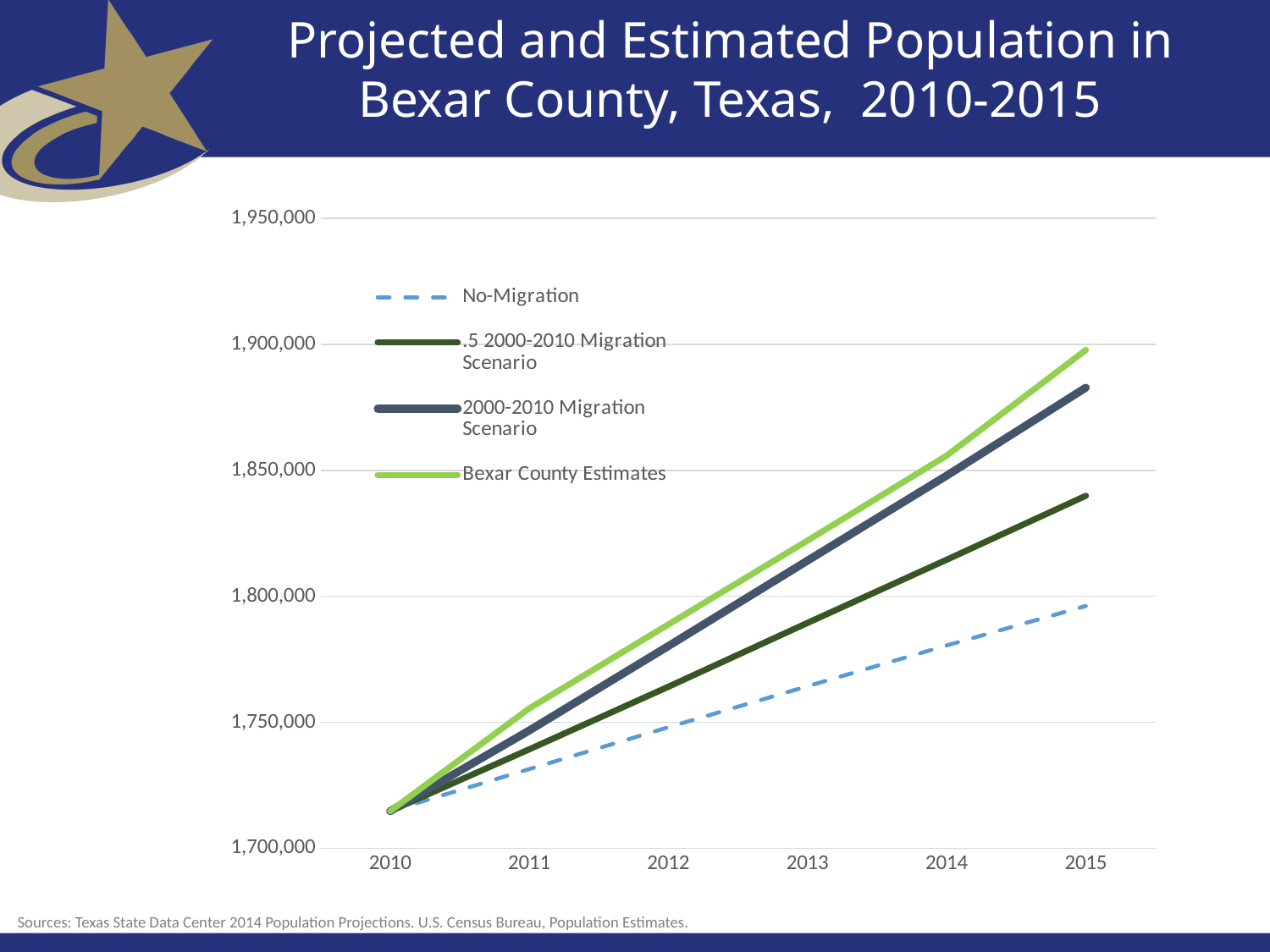
How many series does the legend list? 4 How many years are shown along the x axis? 6 Is the value for No-Migration in 2015 greater or less than 1,750,000? greater What kind of chart is shown on the slide? Line chart Is the value for the .5 2000-2010 Migration Scenario in 2015 greater or less than 1,850,000? less Which series is drawn with a dashed line? No-Migration Which series has the highest value in 2015? Bexar County Estimates Is the value for Bexar County Estimates in 2015 greater or less than 1,850,000? greater In 2015, which is larger: the 2000-2010 Migration Scenario or the .5 2000-2010 Migration Scenario? 2000-2010 Migration Scenario Do the values for the Bexar County Estimates series rise or fall from 2010 to 2015? Rise Which series has the lowest value in 2015? No-Migration